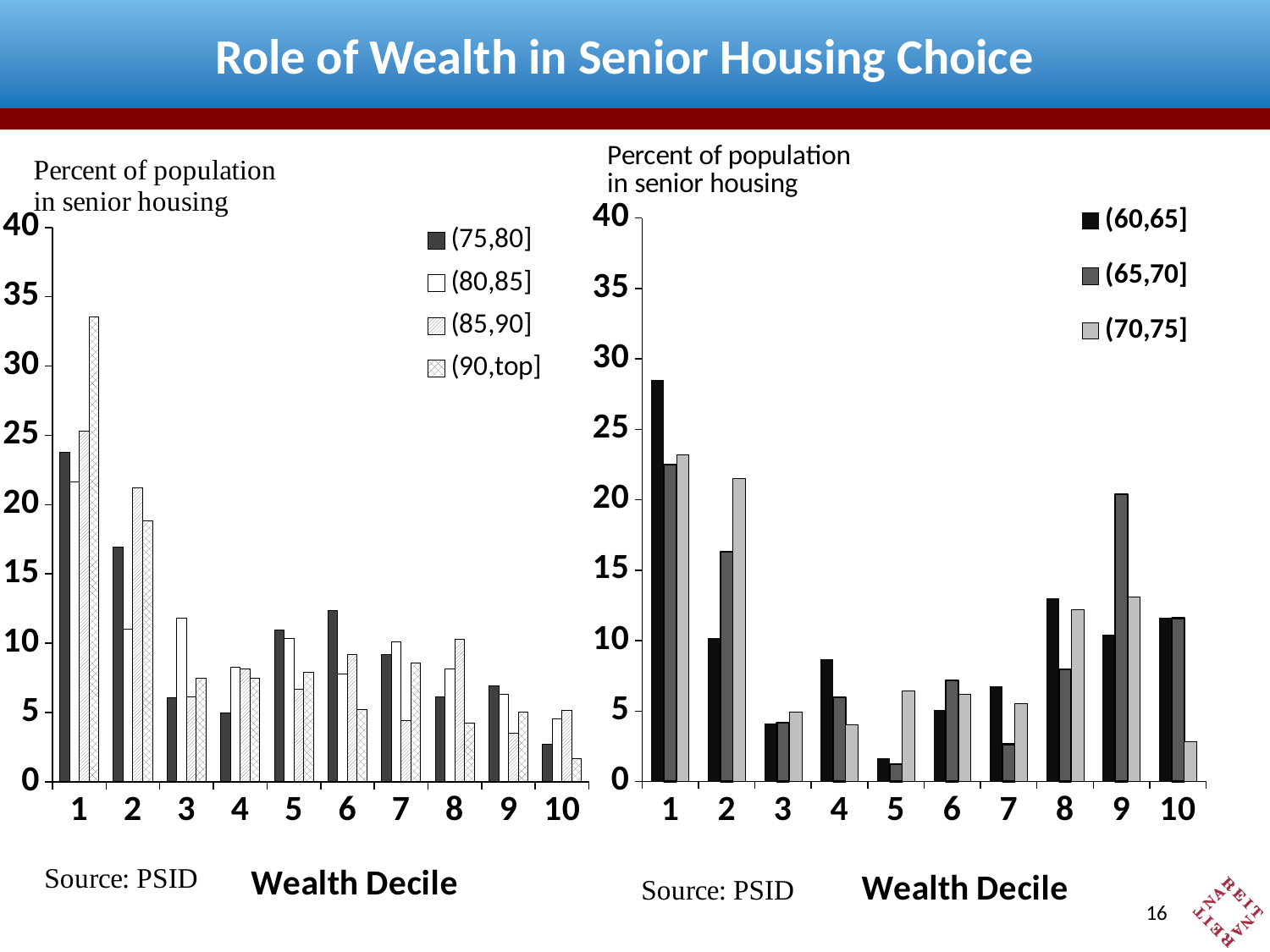
On the right chart, which wealth decile has the lowest value for the (65,70] series? 5 What is the x-axis title of the right chart? Wealth Decile On the left chart, how many wealth deciles are shown on the x axis? 10 On the right chart, which wealth decile has the highest value for the (60,65] series? 1 On the left chart, in wealth decile 2, which series has the larger value, (75,80] or (80,85]? (75,80] On the left chart, is the value for the (90,top] series in wealth decile 1 greater or less than 30? greater On the right chart, how many series does the legend list? 3 What kind of chart is the right chart? Bar chart On the left chart, how many series does the legend list? 4 On the left chart, which wealth decile has the highest value for the (90,top] series? 1 On the right chart, is the value for the (60,65] series in wealth decile 1 greater or less than 25? greater On the right chart, in wealth decile 9, which series has the larger value, (65,70] or (70,75]? (65,70]